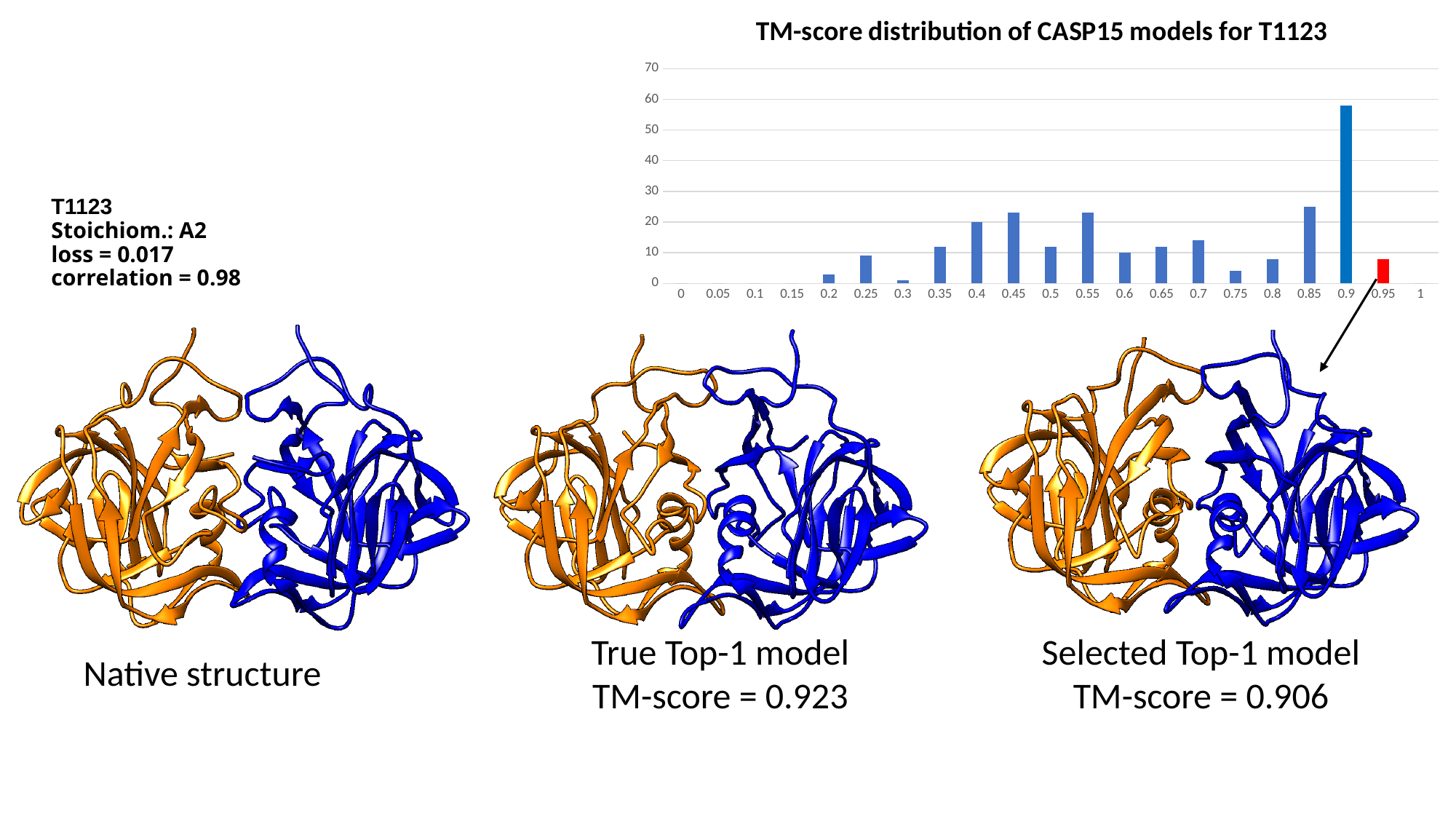
Which bin has the larger value, 0.25 or 0.75? 0.25 Is the value for the 0.9 bin greater or less than 50? greater Which TM-score bin has the tallest bar? 0.9 Is the value for the 0.85 bin greater or less than 20? greater Is the value for the 0.95 bin greater or less than 10? less Which bin has the larger value, 0.85 or 0.9? 0.9 Among the bins with a visible bar, which TM-score bin has the shortest bar? 0.3 Which TM-score bin is drawn in red instead of blue? 0.95 What is the title of the chart? TM-score distribution of CASP15 models for T1123 What kind of chart is shown on the slide? bar chart